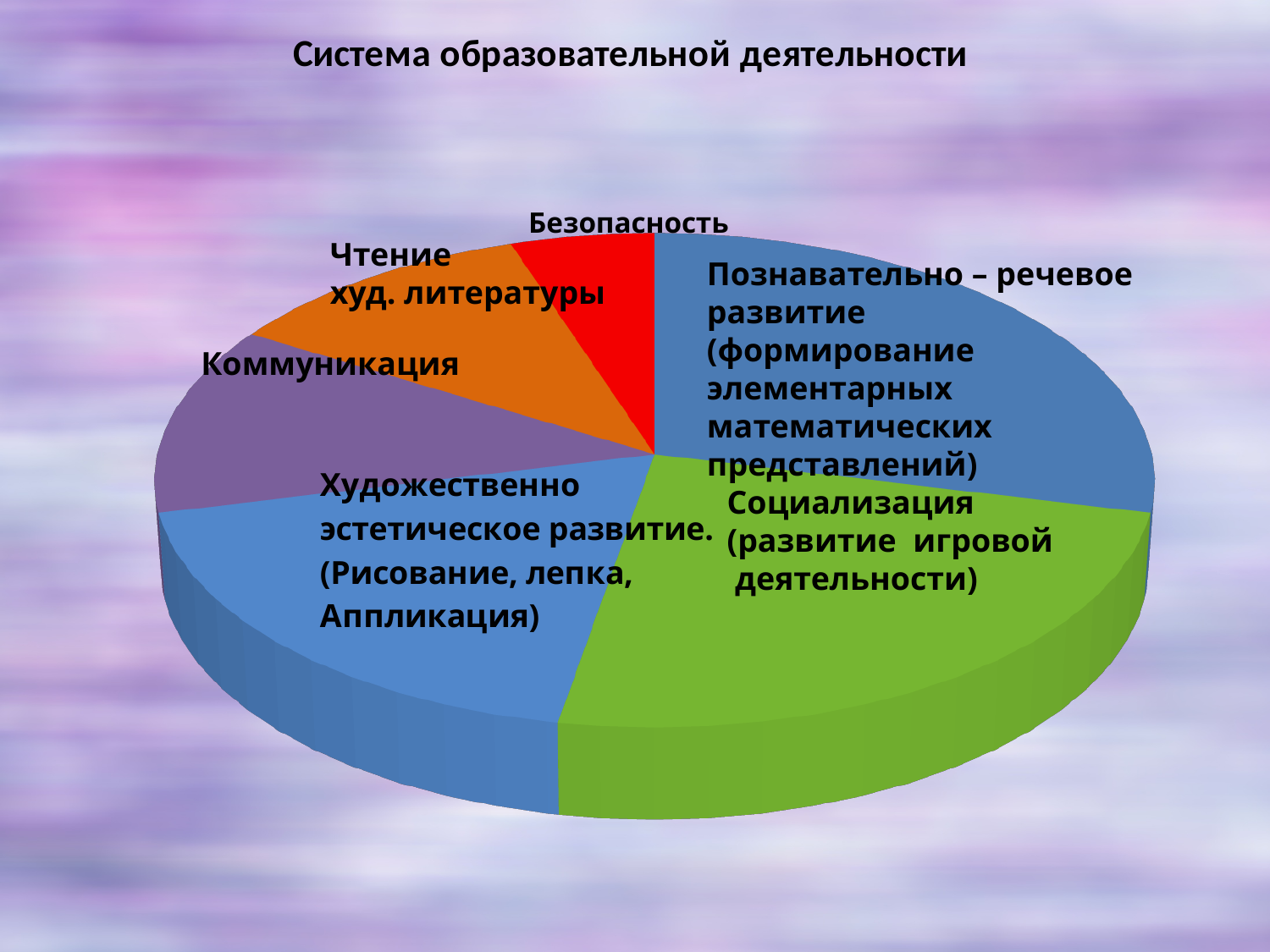
Which slice is larger: Чтение худ. литературы or Художественно эстетическое развитие? Художественно эстетическое развитие Which slice is larger: Безопасность or Коммуникация? Коммуникация Which category has the smallest slice in the pie chart? Безопасность What kind of chart is shown on the slide? pie chart What colour is the Безопасность slice? red Which slice is larger: Безопасность or Социализация (развитие игровой деятельности)? Социализация (развитие игровой деятельности) What is the title of the slide? Система образовательной деятельности How many slices does the pie chart have? 6